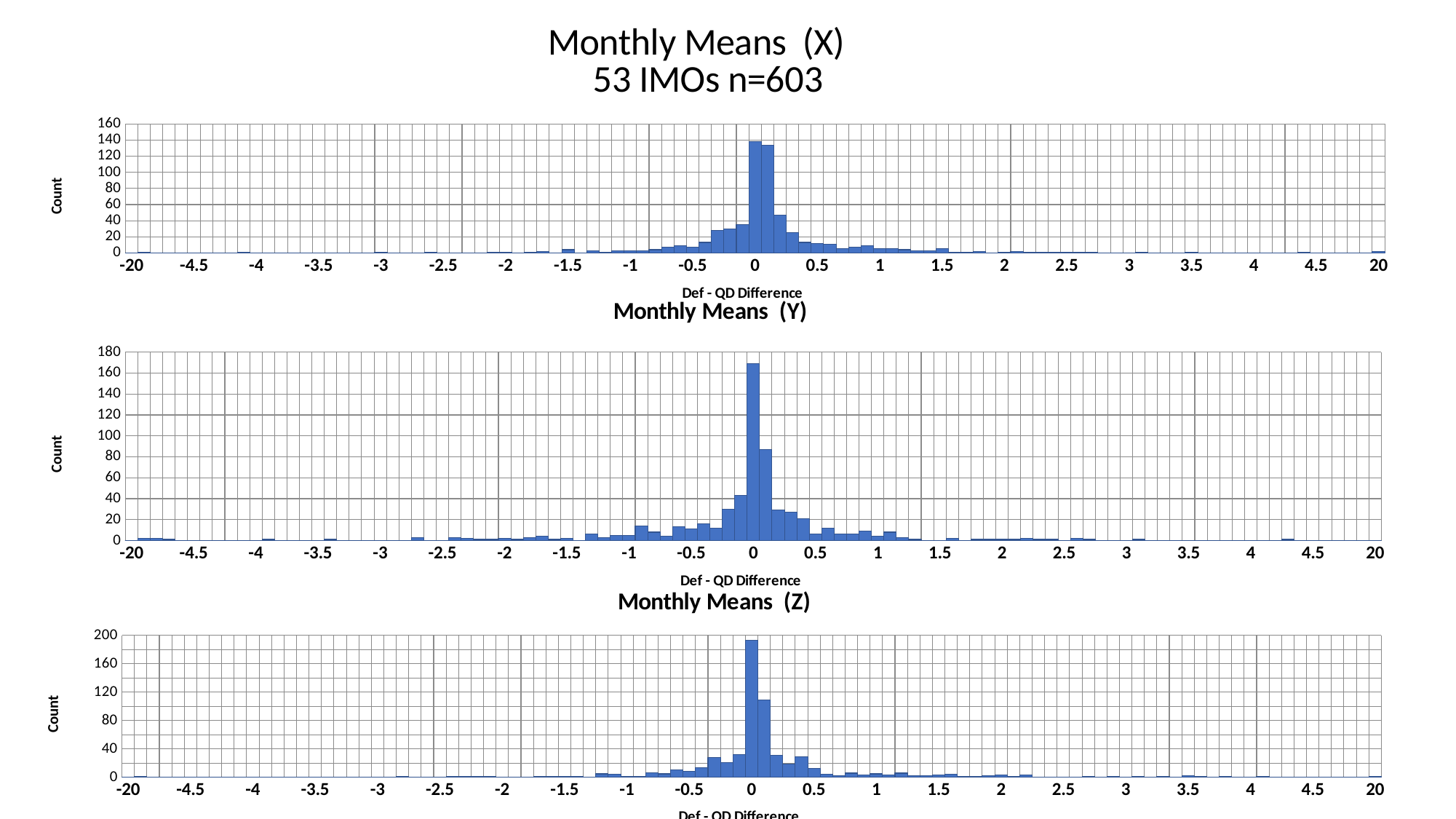
What kind of chart is the top chart titled "Monthly Means (X)"? bar chart In the middle chart "Monthly Means (Y)", around which x-axis value is the tallest bar located? 0 What is the x-axis label of the middle chart "Monthly Means (Y)"? Def - QD Difference How many charts are shown on the slide? 3 In the middle chart "Monthly Means (Y)", is the tallest bar greater or less than 160? greater In the bottom chart "Monthly Means (Z)", is the tallest bar greater or less than 160? greater In the top chart "Monthly Means (X)", what is the highest value shown on the y-axis? 160 In the top chart "Monthly Means (X)", is the tallest bar greater or less than 120? greater Which chart has the taller peak bar: "Monthly Means (X)" or "Monthly Means (Z)"? Monthly Means (Z)